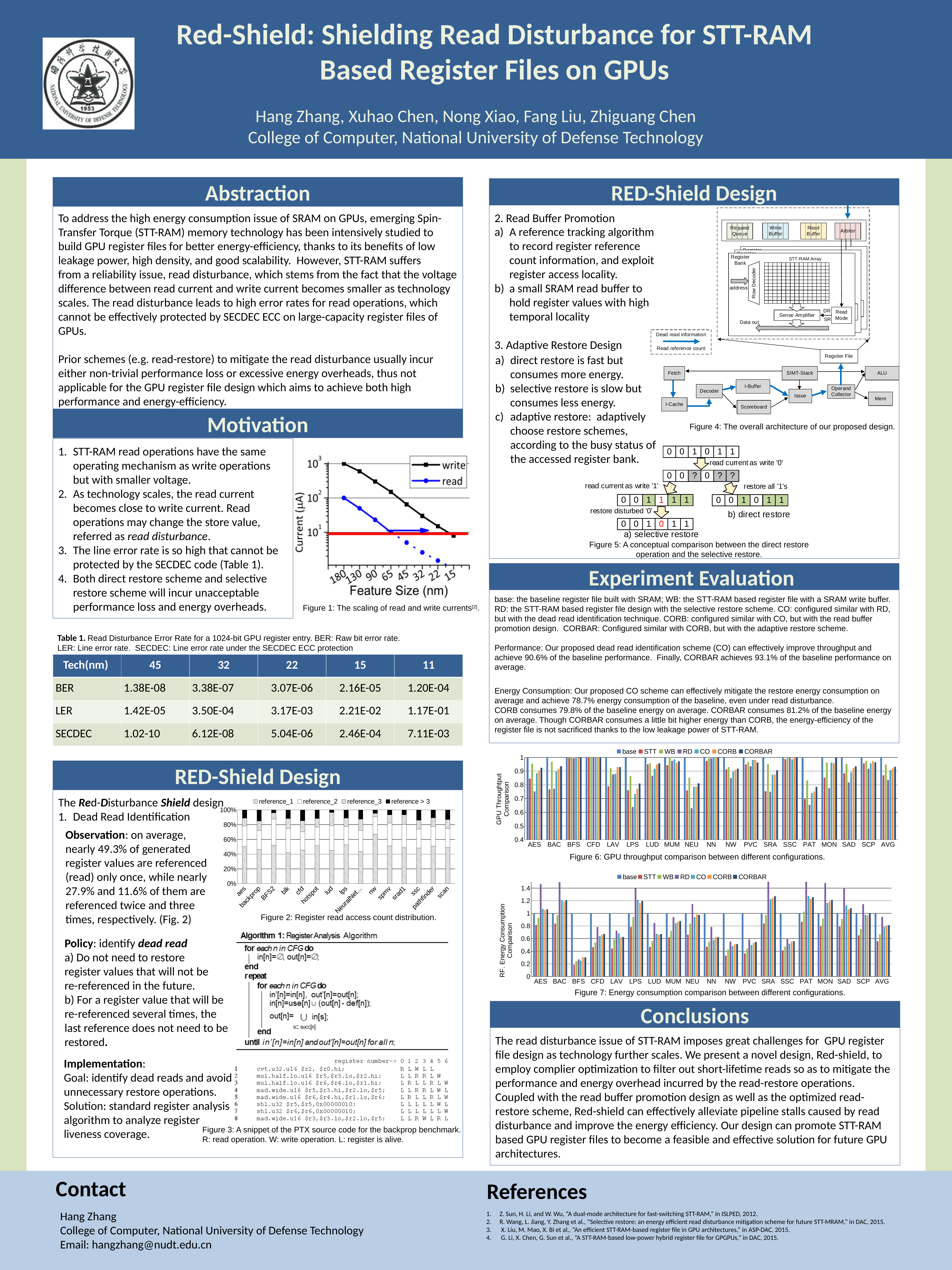
How many series does the legend of Figure 1 list? 2 How many categories are shown on the x axis of Figure 6 (GPU throughput comparison)? 19 How many series does the legend of Figure 2 list? 4 How many configurations does the legend of Figure 6 (GPU throughput comparison) list? 7 In Figure 7 (energy consumption comparison), which configuration has the highest value for SRA? RD What kind of chart is Figure 1 (the scaling of read and write currents)? line chart In Figure 6 (GPU throughput comparison), is the STT value for AES greater or less than 0.9? less In Figure 7 (energy consumption comparison), is the base value for BFS greater or less than 0.5? greater In Figure 1, does the write current rise or fall as the feature size goes from 180 nm to 15 nm? fall How many benchmark categories are shown on the x axis of Figure 2? 15 What kind of chart is Figure 2 (register read access count distribution)? stacked bar chart